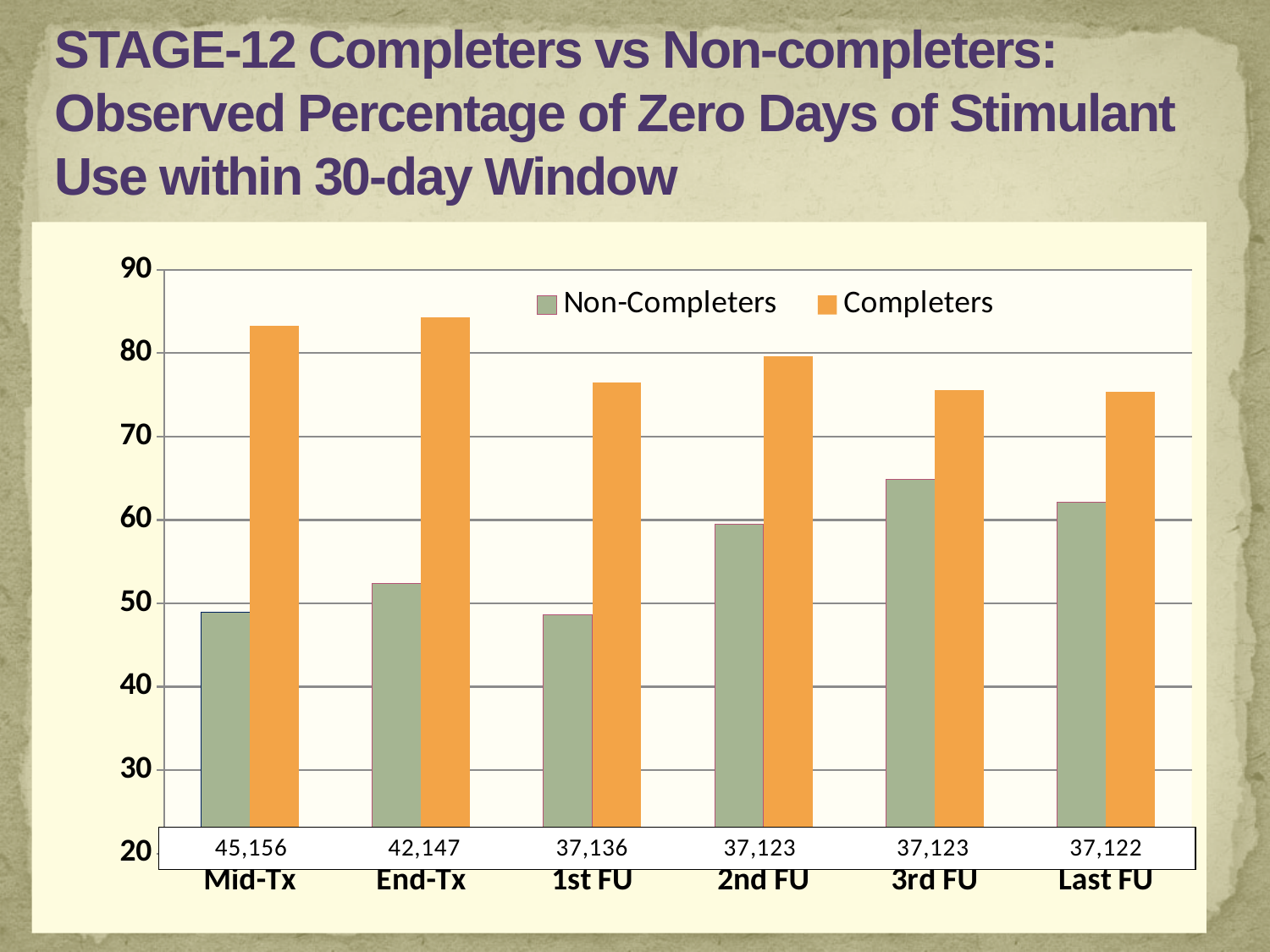
Is the Non-Completers value at 3rd FU greater or less than 60? greater How many series does the legend list? 2 For Completers, is the value at Last FU higher or lower than at Mid-Tx? lower At 2nd FU, which series has the larger value, Non-Completers or Completers? Completers Is the Non-Completers value at Mid-Tx greater or less than 50? less How many time-point categories are shown on the x axis? 6 What kind of chart is shown on the slide? bar chart What colour are the Completers bars? orange For Non-Completers, which time point has the highest value? 3rd FU Is the Completers value at Mid-Tx greater or less than 80? greater